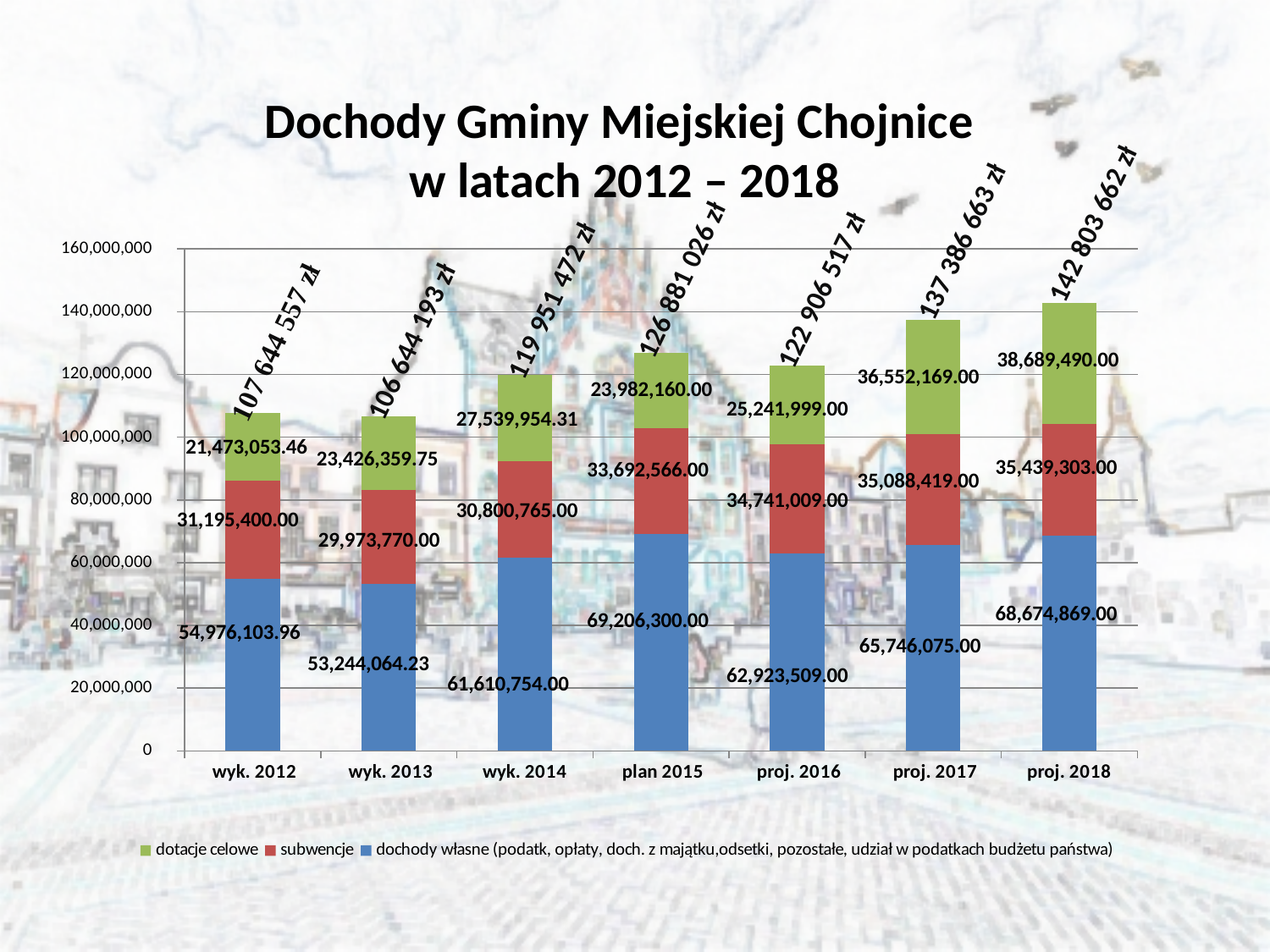
Which is larger: dotacje celowe in wyk. 2013 or in plan 2015? plan 2015 What is the difference between dochody własne in plan 2015 and wyk. 2014? 7,595,546.00 Which year has the lowest total income? wyk. 2013 What is the total income shown above the proj. 2018 bar? 142 803 662 zł How many years (categories) are shown on the x axis? 7 What is the value of dotacje celowe for wyk. 2014? 27,539,954.31 What kind of chart is shown on the slide? stacked bar chart What is the value of dochody własne for wyk. 2012? 54,976,103.96 Which year has the highest total income? proj. 2018 How many series does the legend list? 3 What is the difference between subwencje in proj. 2018 and proj. 2017? 350,884.00 What is the value of subwencje for proj. 2017? 35,088,419.00